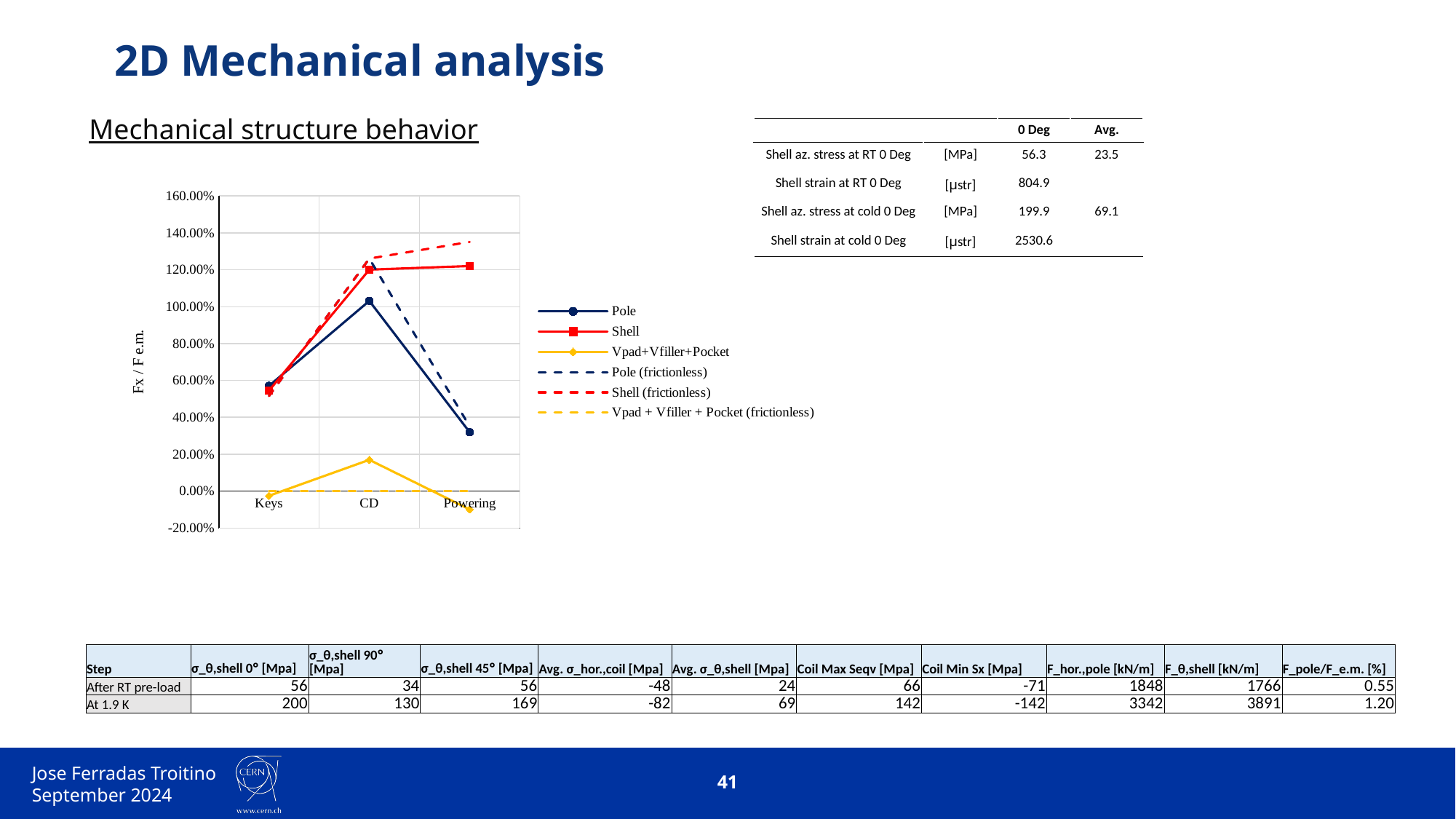
What is the y-axis label of the chart? Fx / F e.m. Is the value of the Shell series at CD greater or less than 100.00%? greater How many categories are shown on the x axis of the chart? 3 At Powering, which is larger: the Shell series or the Pole series? Shell How many series does the chart legend list? 6 Is the value of the Pole series at Powering greater or less than 40.00%? less How does the Pole series change from Keys to CD to Powering? rises then falls At which category does the Pole series reach its highest value? CD Is the value of the Pole series at Keys greater or less than 40.00%? greater What kind of chart is shown on the slide? line chart Which legend entry is drawn as a solid red line with square markers? Shell